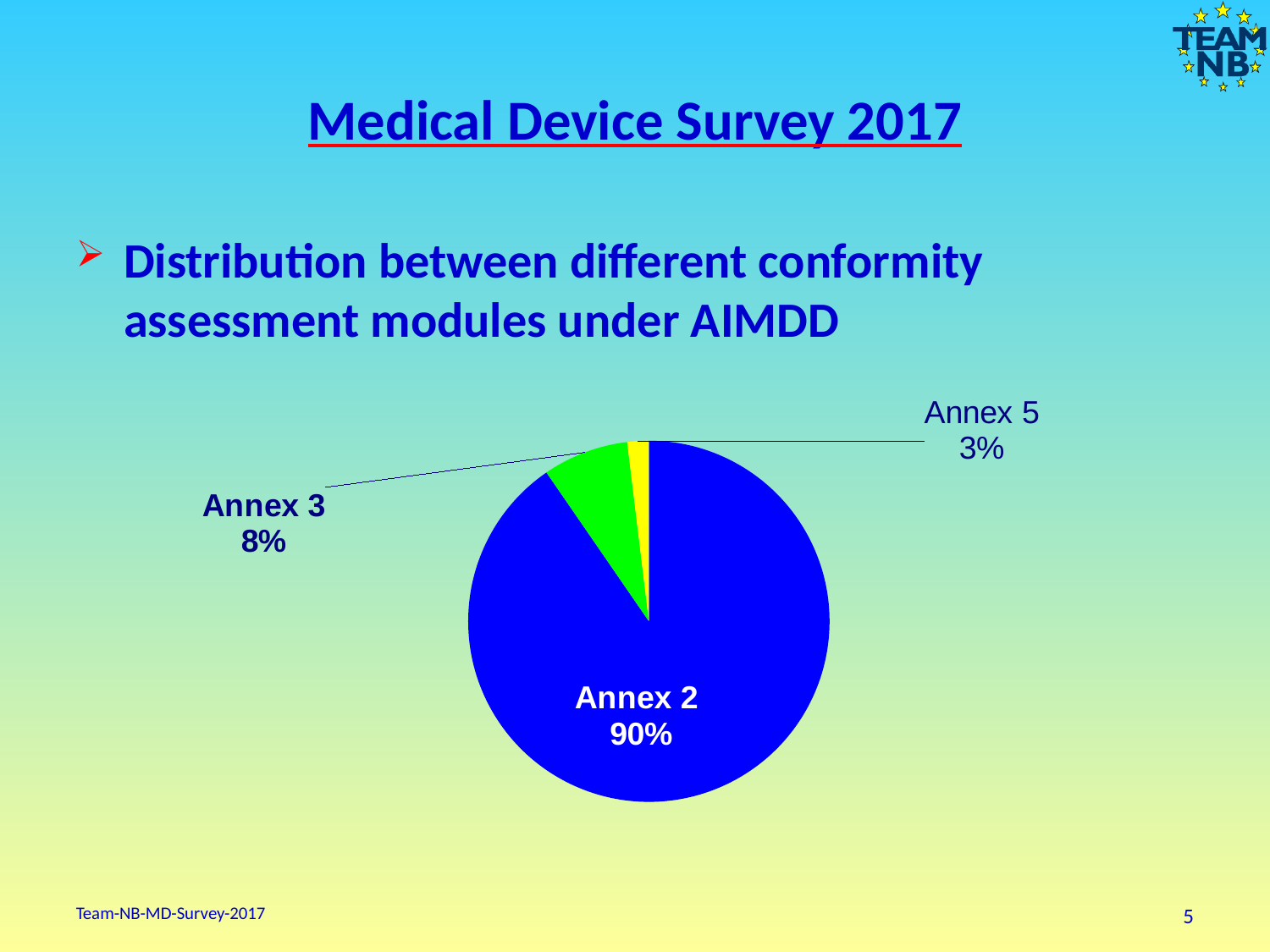
What is the difference in percentage points between the shares of Annex 2 and Annex 3? 82 Which has a larger share, Annex 3 or Annex 5? Annex 3 What colour is the Annex 3 slice? Green What is the difference in percentage points between the shares of Annex 3 and Annex 5? 5 What kind of chart is shown on the slide? Pie chart What colour is the Annex 2 slice? Blue What share of the pie does Annex 5 represent? 3% What share of the pie does Annex 2 represent? 90% What share of the pie does Annex 3 represent? 8% Which annex has the largest share of the pie? Annex 2 Which annex has the smallest share of the pie? Annex 5 How many slices does the pie chart have? 3